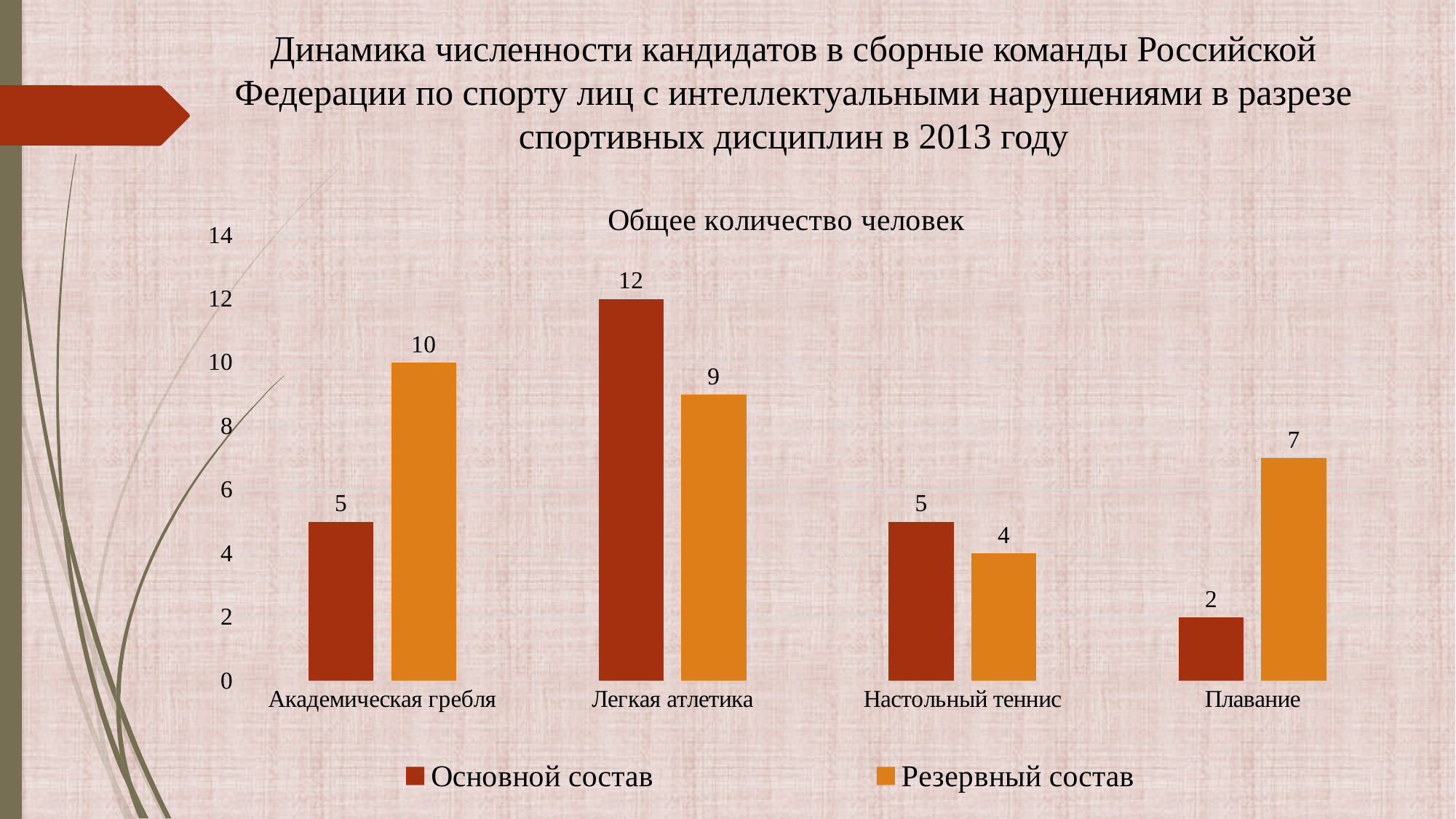
Which is larger for Плавание: Основной состав or Резервный состав? Резервный состав What is the value of Основной состав for Плавание? 2 What kind of chart is shown on the slide? Bar chart How many series does the legend list? 2 What is the difference between Основной состав and Резервный состав for Легкая атлетика? 3 How many categories are shown on the x axis? 4 Which category has the highest value for Основной состав? Легкая атлетика What is the value of Резервный состав for Академическая гребля? 10 What is the title of the chart? Общее количество человек What is the value of Резервный состав for Настольный теннис? 4 What is the value of Основной состав for Легкая атлетика? 12 Which category has the lowest value for Резервный состав? Настольный теннис